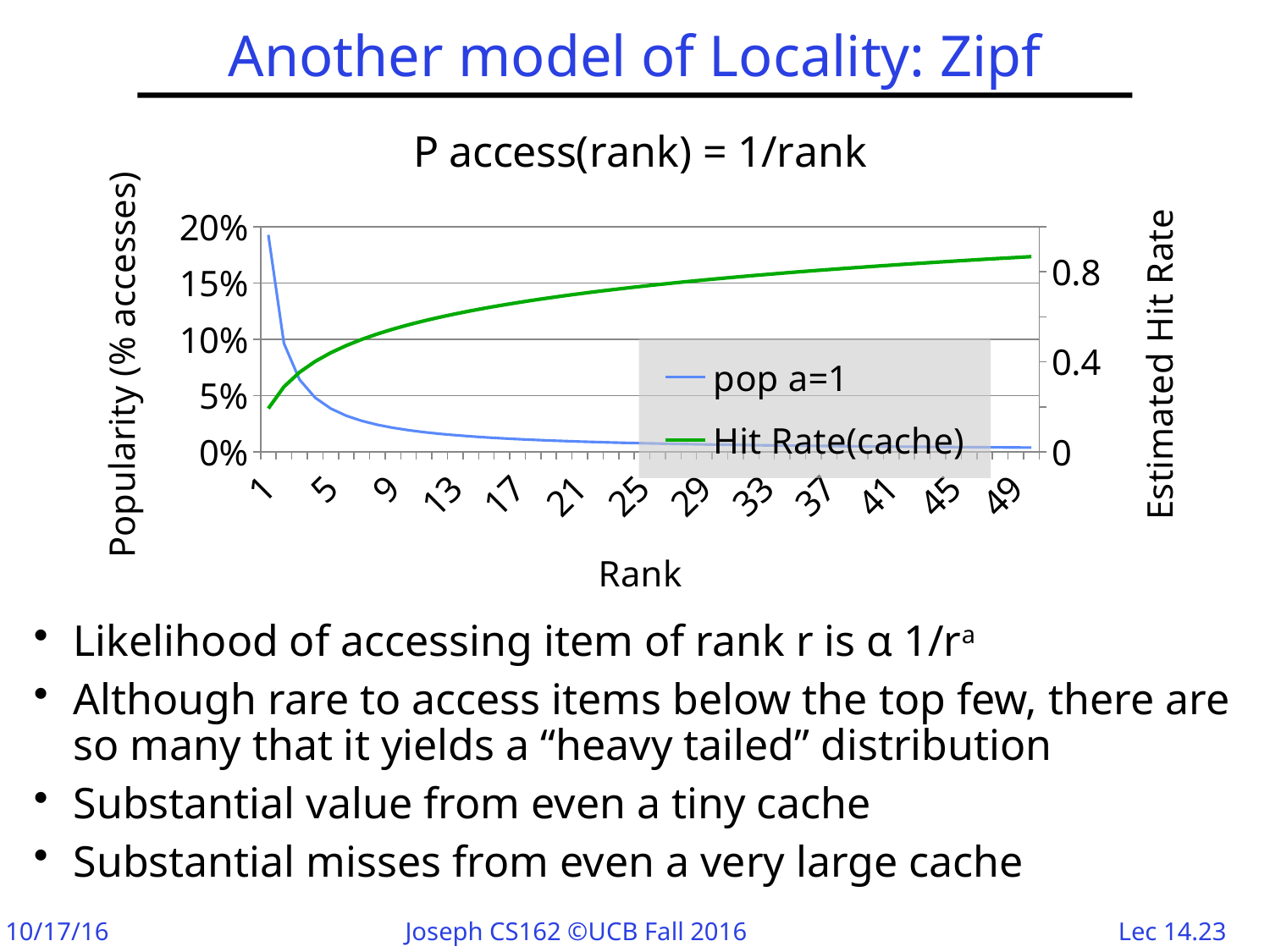
Is the value of 'Hit Rate(cache)' at rank 25 greater or less than 0.4? greater What is the title of the chart? P access(rank) = 1/rank Is the value of 'pop a=1' at rank 9 greater or less than 5%? less What is the label of the x axis? Rank Does the 'Hit Rate(cache)' series rise or fall as rank increases? Rise How many series does the legend list? 2 Does the 'pop a=1' series rise or fall as rank increases? Fall Which series is higher at rank 1 on its own axis scale: 'pop a=1' relative to the 20% maximum, or 'Hit Rate(cache)' relative to the 0.8 tick — which line is plotted higher on the chart at rank 1? pop a=1 Is the value of 'Hit Rate(cache)' at rank 49 greater or less than 0.8? greater What kind of chart is shown on the slide? Line chart